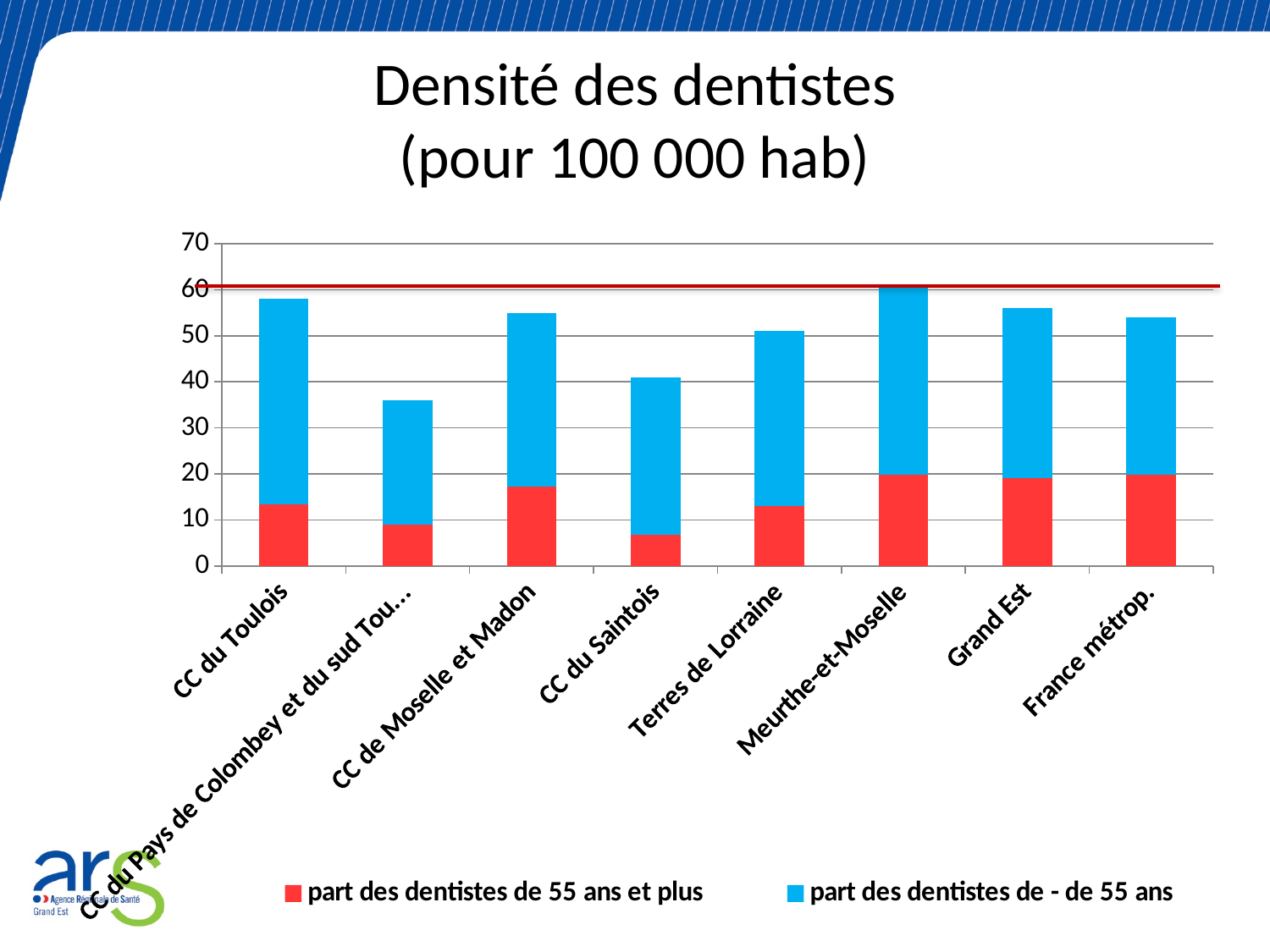
Which category has the lowest total bar height? CC du Pays de Colombey et du sud Tou... Is the total bar for CC du Saintois greater or less than 50? less Which has the taller total bar, CC du Toulois or CC du Saintois? CC du Toulois Is the total bar for CC du Toulois greater or less than 50? greater How many series does the legend list? 2 Is the total bar for CC du Pays de Colombey et du sud Tou... greater or less than 40? less How many categories are shown on the x axis of the chart? 8 Which category has the smallest red segment (part des dentistes de 55 ans et plus)? CC du Saintois What is the title of the chart? Densité des dentistes (pour 100 000 hab) Which has the larger red segment (part des dentistes de 55 ans et plus), CC de Moselle et Madon or CC du Toulois? CC de Moselle et Madon What kind of chart is shown on the slide? bar chart